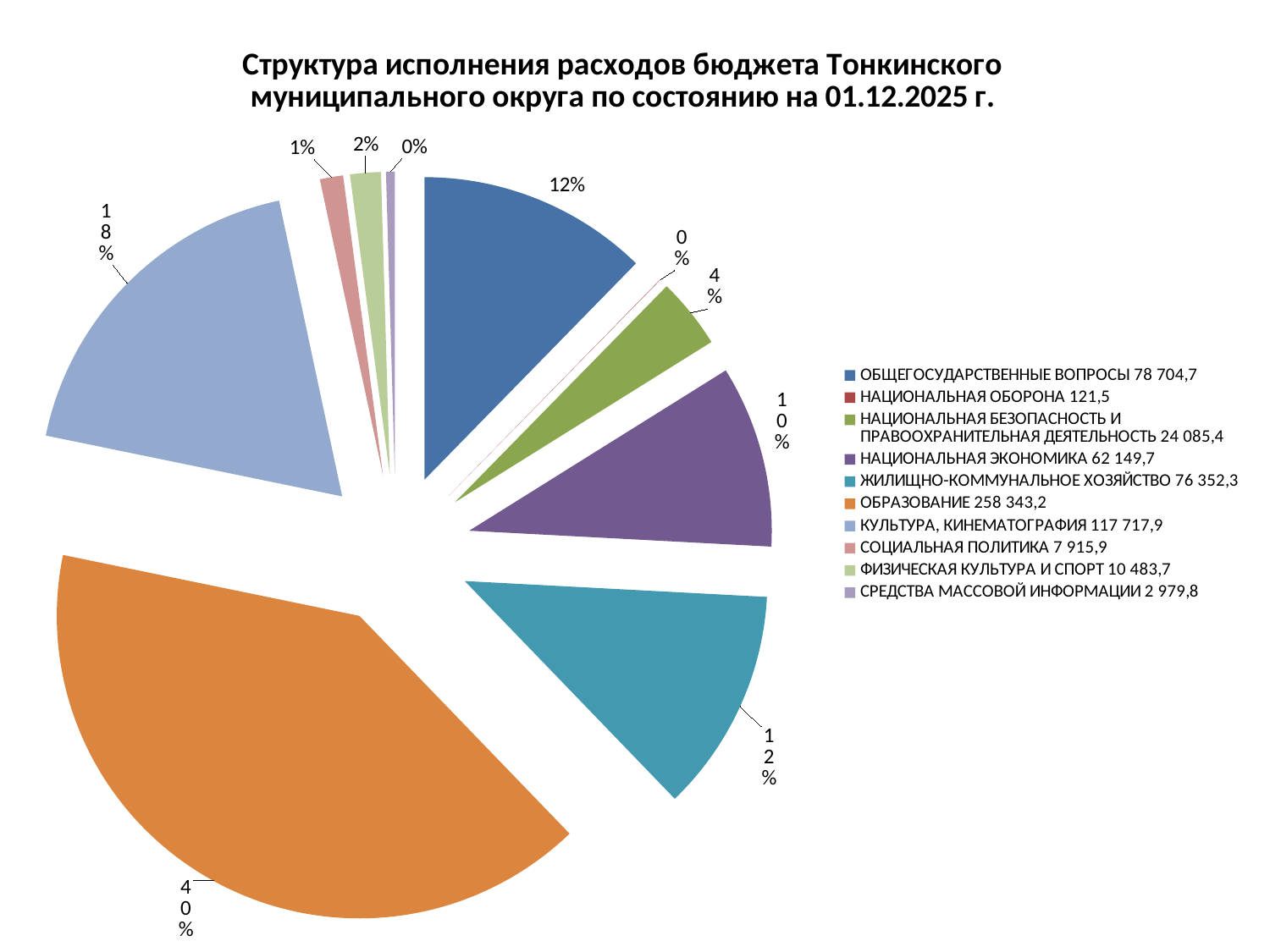
What value is given in the legend for ЖИЛИЩНО-КОММУНАЛЬНОЕ ХОЗЯЙСТВО? 76 352,3 What percentage share is shown for the ОБРАЗОВАНИЕ slice? 40% What value is given in the legend for ОБРАЗОВАНИЕ? 258 343,2 What colour is the ОБРАЗОВАНИЕ slice? orange What kind of chart is shown on the slide? pie chart What percentage share is shown for the НАЦИОНАЛЬНАЯ ЭКОНОМИКА slice? 10% Which category has the largest share of the pie? ОБРАЗОВАНИЕ What percentage share is shown for the КУЛЬТУРА, КИНЕМАТОГРАФИЯ slice? 18% How many entries does the legend list? 10 How many slices does the pie chart have? 10 Which is larger: the value for КУЛЬТУРА, КИНЕМАТОГРАФИЯ or the value for НАЦИОНАЛЬНАЯ ЭКОНОМИКА? КУЛЬТУРА, КИНЕМАТОГРАФИЯ What value is given in the legend for НАЦИОНАЛЬНАЯ ОБОРОНА? 121,5